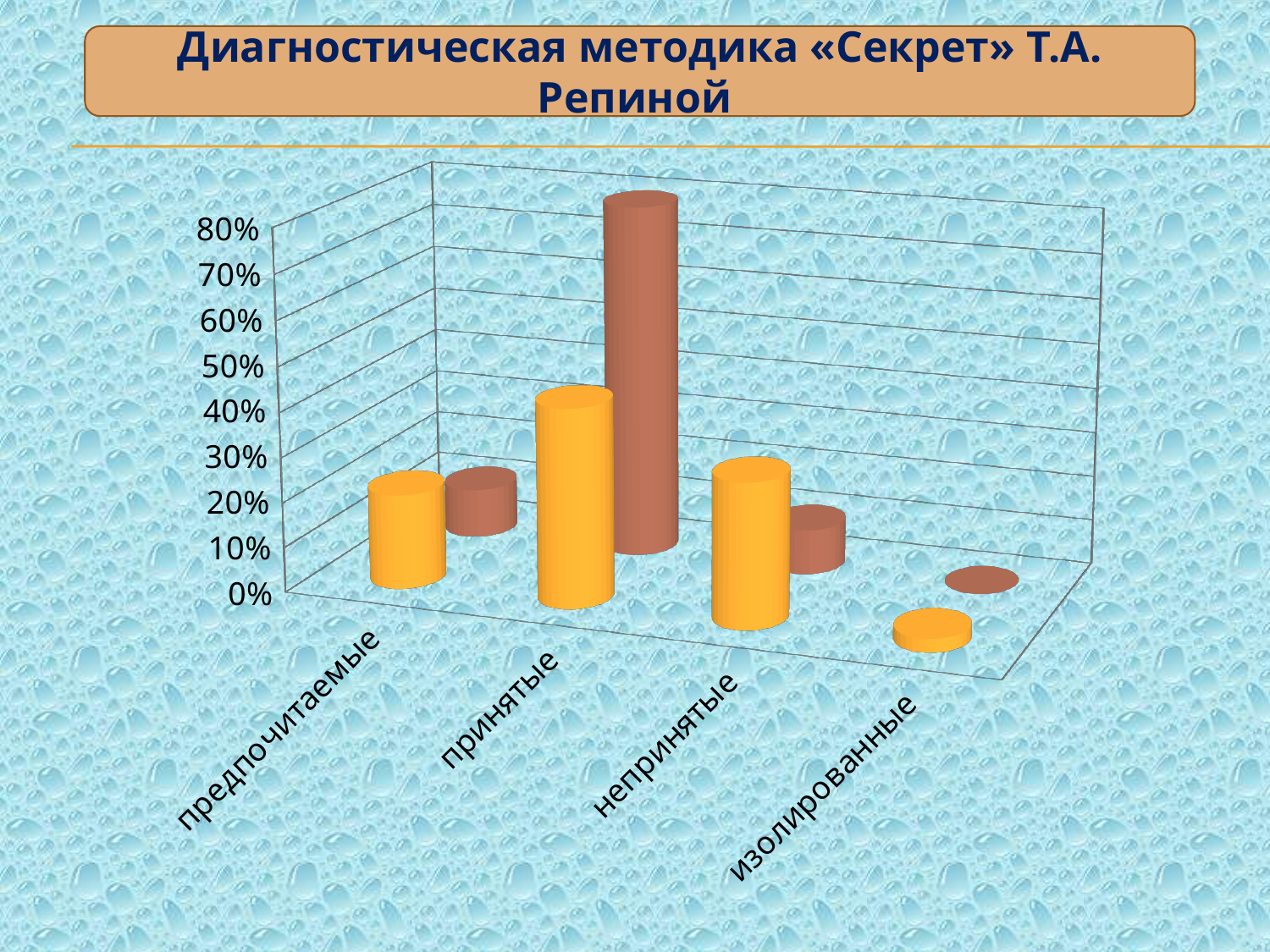
Which category has the tallest bar on the chart? принятые How many bars are plotted for each category on the chart? 2 Is the orange bar for непринятые greater or less than 50%? less How many categories are shown on the x axis of the chart? 4 Which category has the lowest bars on the chart? изолированные What is the title of the slide containing the chart? Диагностическая методика «Секрет» Т.А. Репиной Is the brown bar for предпочитаемые greater or less than 40%? less What kind of chart is shown on the slide? bar chart Which orange bar is taller: предпочитаемые or принятые? принятые Which is larger for принятые: the orange bar or the brown bar? the brown bar Is the brown bar for принятые greater or less than 50%? greater